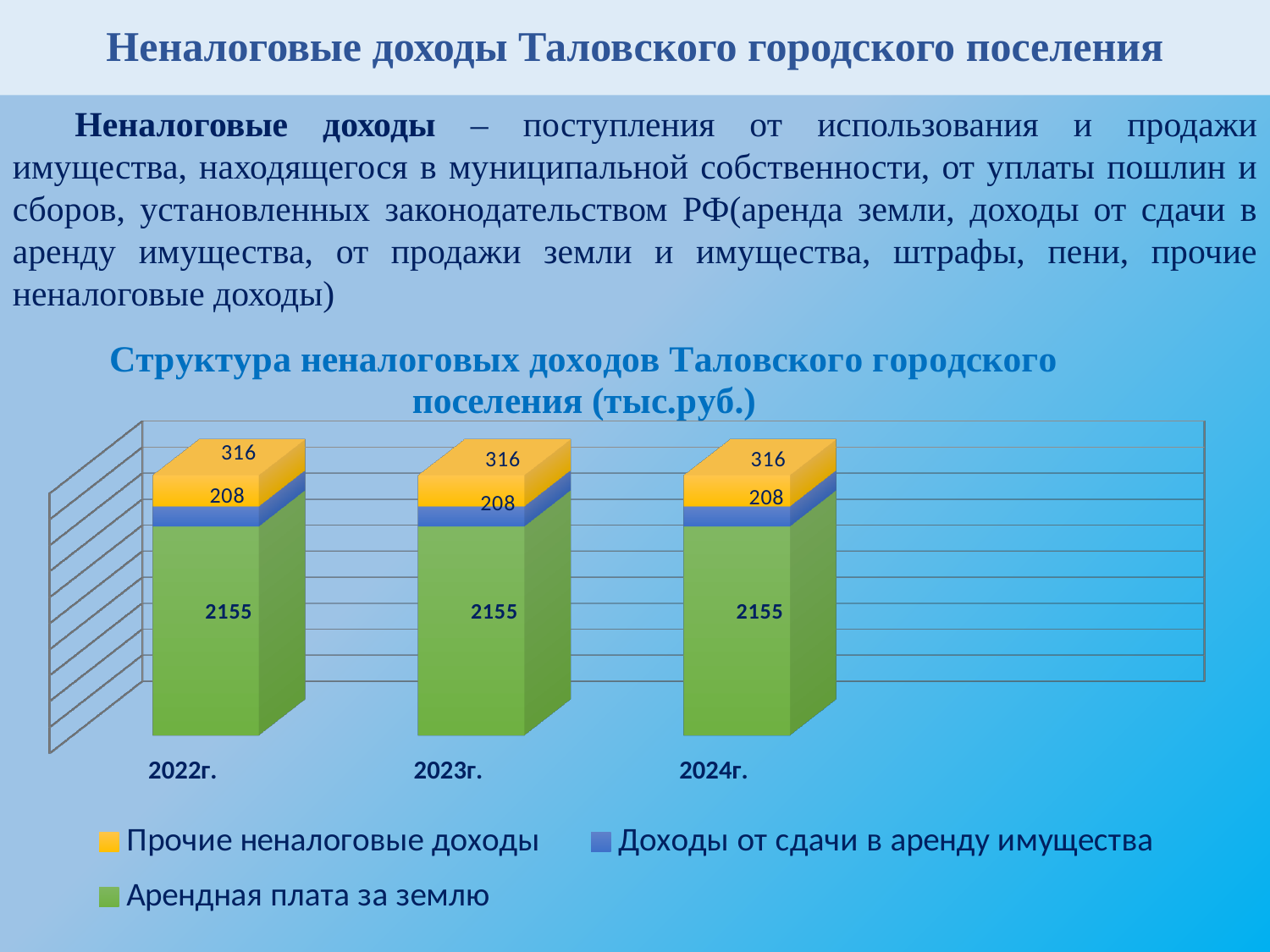
Which series has the largest value in 2023г.? Арендная плата за землю Does the value of Арендная плата за землю rise, fall or stay the same from 2022г. to 2024г.? stays the same Which colour represents Прочие неналоговые доходы in the chart? yellow What is the total of the stacked bar for 2024г.? 2679 What is the value of Арендная плата за землю for 2022г.? 2155 What is the difference between Прочие неналоговые доходы and Доходы от сдачи в аренду имущества in 2022г.? 108 What is the value of Доходы от сдачи в аренду имущества for 2023г.? 208 What is the value of Прочие неналоговые доходы for 2024г.? 316 How many series does the chart legend list? 3 What type of chart is shown on the slide? stacked bar chart How many years (categories) are shown on the x axis of the chart? 3 Which series has the smallest value in 2024г.? Доходы от сдачи в аренду имущества